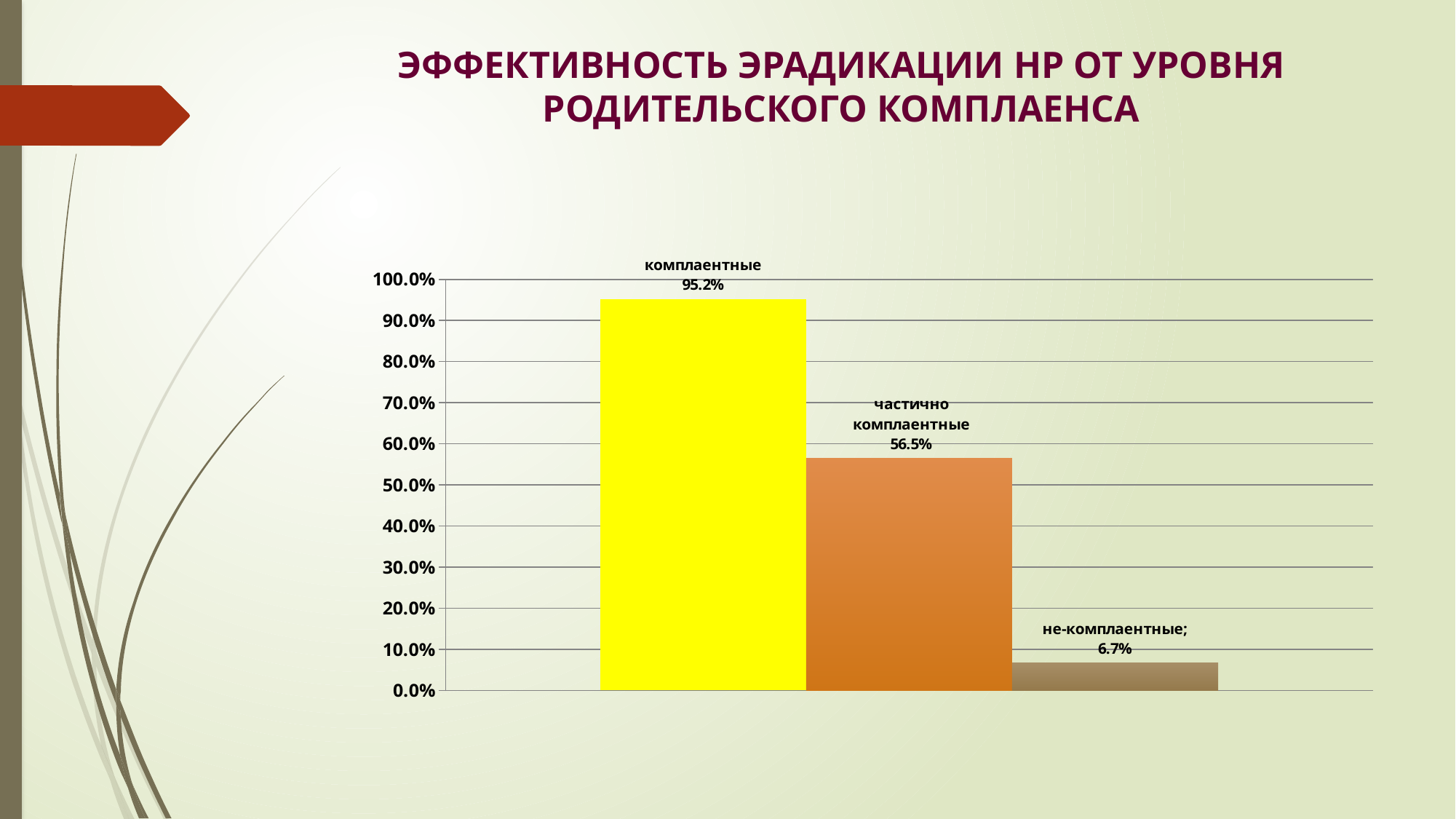
Do the values rise or fall from left to right across the categories? fall What is the value for не-комплаентные? 6.7% What is the value for комплаентные? 95.2% What is the value for частично комплаентные? 56.5% What is the difference between the values for комплаентные and частично комплаентные? 38.7% How many categories are shown in the chart? 3 Which category has the highest value? комплаентные What is the difference between the values for частично комплаентные and не-комплаентные? 49.8% What kind of chart is shown on the slide? bar chart Which is larger, the value for частично комплаентные or the value for не-комплаентные? частично комплаентные Which category has the lowest value? не-комплаентные Is the value for частично комплаентные greater or less than 50.0%? greater